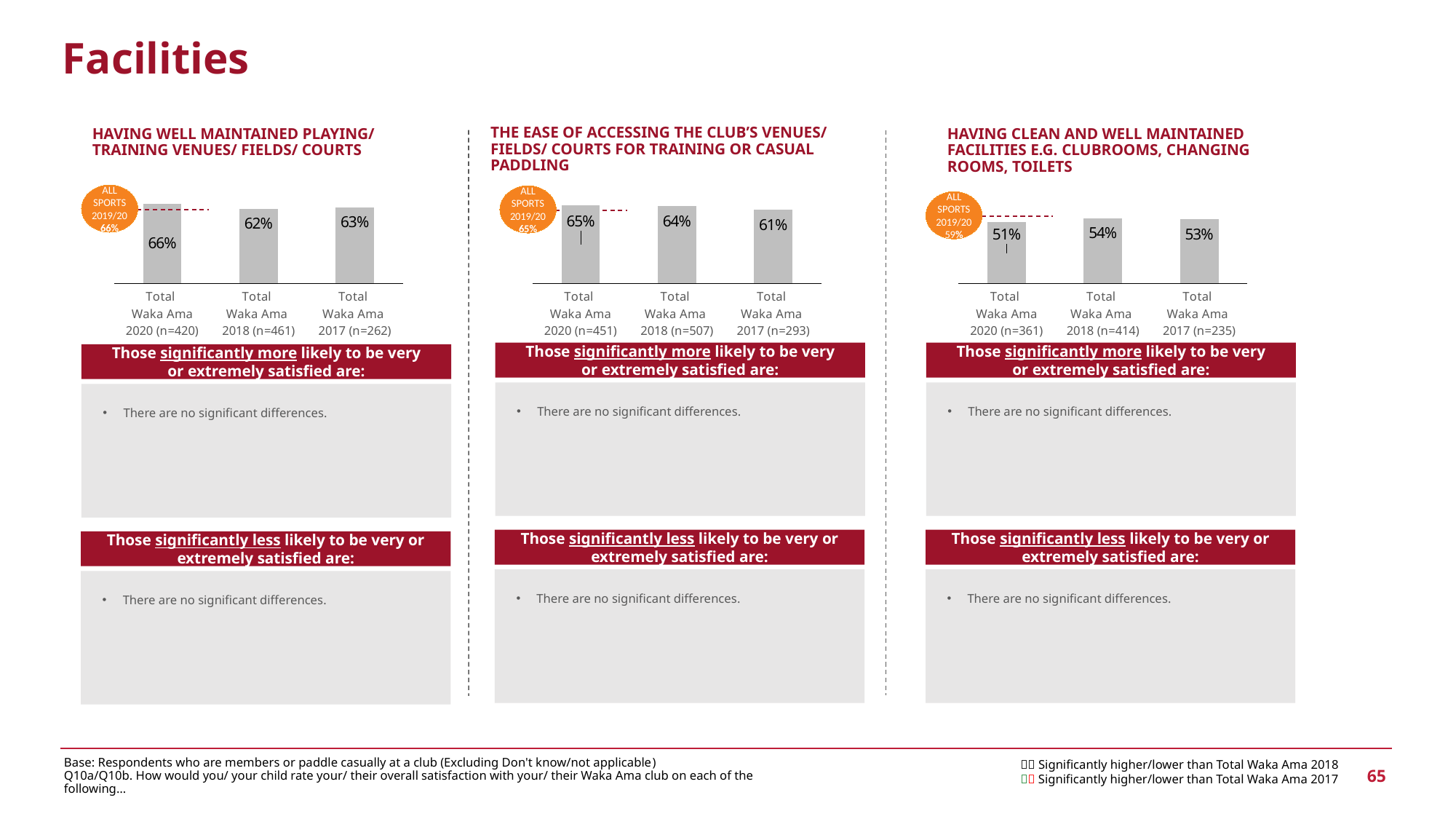
In the 'Having clean and well maintained facilities e.g. clubrooms, changing rooms, toilets' chart, what is the difference between Total Waka Ama 2018 and Total Waka Ama 2020? 3% In the 'Having clean and well maintained facilities e.g. clubrooms, changing rooms, toilets' chart, what is the value for Total Waka Ama 2018 (n=414)? 54% What type of chart is used in the 'Having well maintained playing/ training venues/ fields/ courts' section? Bar chart In the 'Having clean and well maintained facilities e.g. clubrooms, changing rooms, toilets' chart, which is larger: Total Waka Ama 2018 or Total Waka Ama 2017? Total Waka Ama 2018 In 'The ease of accessing the club's venues/ fields/ courts for training or casual paddling' chart, how many bars are plotted? 3 In the 'Having well maintained playing/ training venues/ fields/ courts' chart, which category has the lowest value? Total Waka Ama 2018 (n=461) In the 'Having clean and well maintained facilities e.g. clubrooms, changing rooms, toilets' chart, what is the All Sports 2019/20 benchmark value shown in the orange circle? 59% In the 'Having clean and well maintained facilities e.g. clubrooms, changing rooms, toilets' chart, which category has the lowest value? Total Waka Ama 2020 (n=361) In the 'Having well maintained playing/ training venues/ fields/ courts' chart, what is the difference between Total Waka Ama 2020 and Total Waka Ama 2018? 4% In 'The ease of accessing the club's venues/ fields/ courts for training or casual paddling' chart, what is the value for Total Waka Ama 2017 (n=293)? 61% In the 'Having well maintained playing/ training venues/ fields/ courts' chart, what is the value for Total Waka Ama 2020 (n=420)? 66% In 'The ease of accessing the club's venues/ fields/ courts for training or casual paddling' chart, which category has the highest value? Total Waka Ama 2020 (n=451)